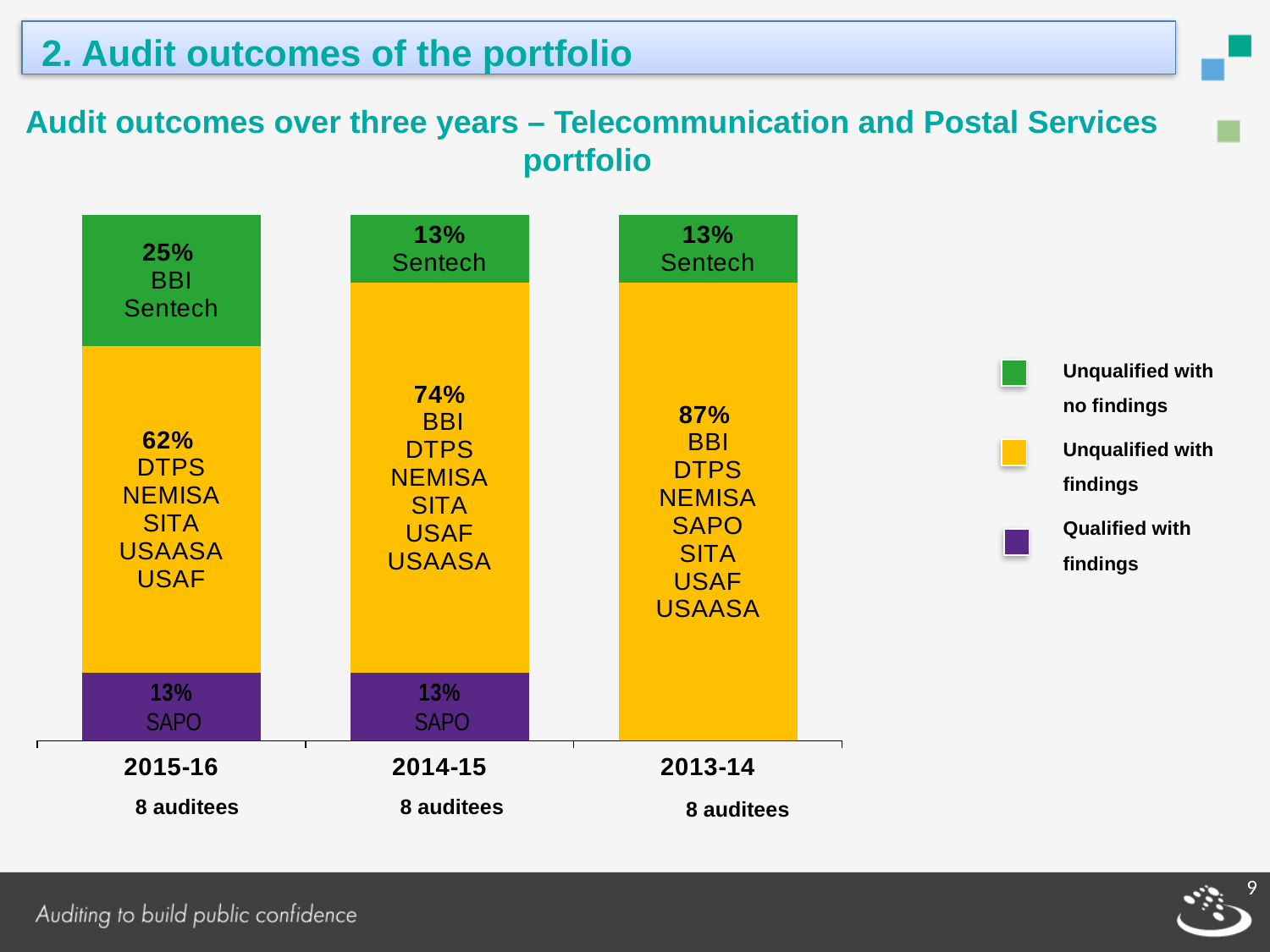
What percentage of auditees were unqualified with findings in 2013-14? 87% What is the difference between the unqualified with findings share in 2013-14 and in 2015-16? 25% How many auditees were there in 2013-14? 8 auditees What kind of chart is shown on the slide? Stacked bar chart Which colour represents 'Qualified with findings' in the legend? Purple What percentage of auditees were qualified with findings in 2014-15? 13% Which year has the highest share of auditees unqualified with no findings? 2015-16 Which year has the lowest share of auditees unqualified with findings? 2015-16 What percentage of auditees were unqualified with no findings in 2015-16? 25% How many years (bars) are shown in the chart? 3 Is the unqualified with findings share larger in 2014-15 or in 2015-16? 2014-15 How many audit outcome categories does the legend list? 3